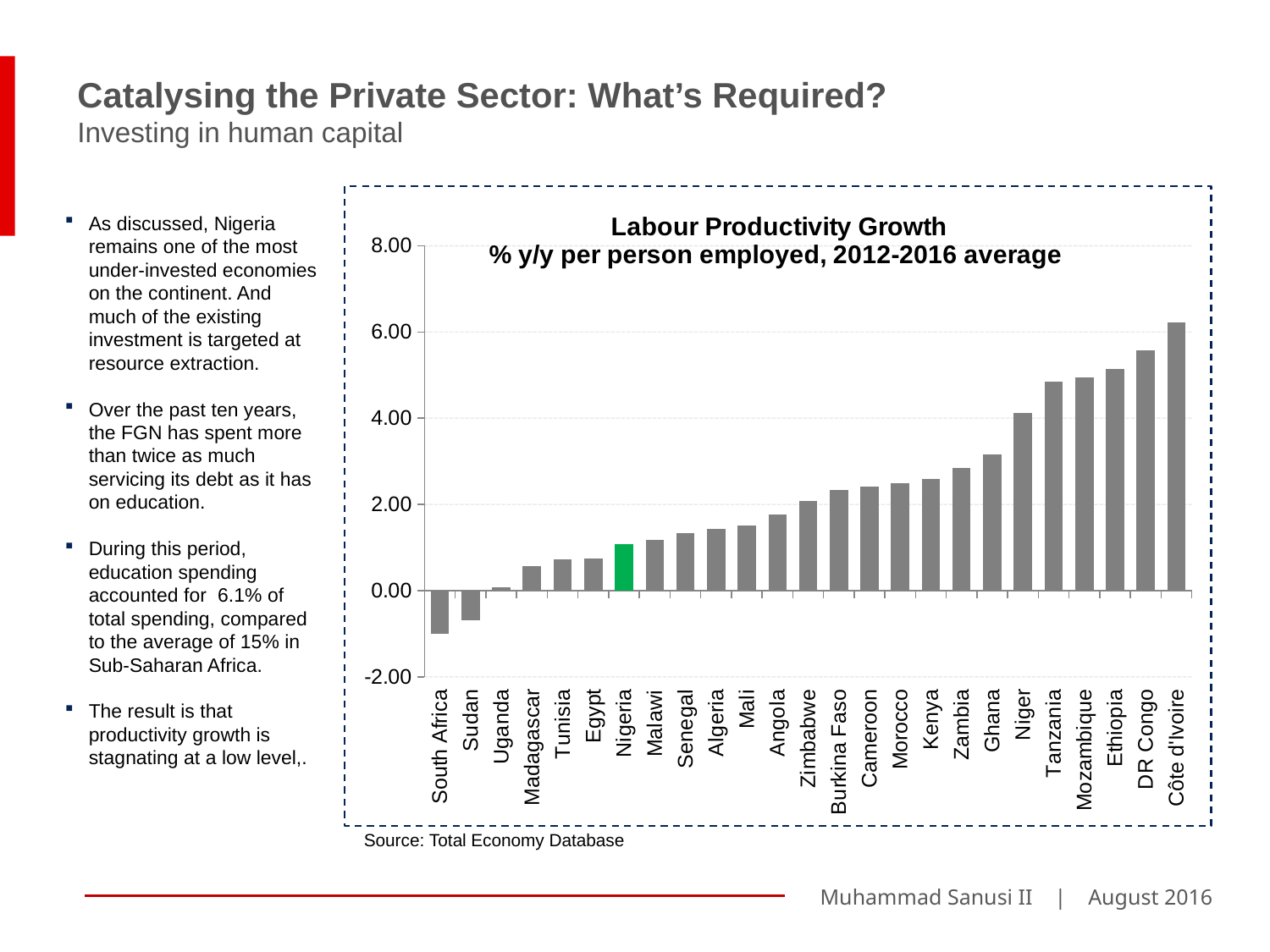
Which country has the lowest labour productivity growth in the chart? South Africa Which country has the highest labour productivity growth in the chart? Côte d'Ivoire Which has the larger labour productivity growth, Sudan or Uganda? Uganda Is the value for Ghana greater or less than 4.00? less Is the value for Côte d'Ivoire greater or less than 6.00? greater What kind of chart is shown on the slide? bar chart Do the bar values rise or fall moving from left to right along the x axis? rise How many countries are plotted in the Labour Productivity Growth chart? 25 Is the value for Nigeria greater or less than 2.00? less Which has the larger labour productivity growth, Ethiopia or Kenya? Ethiopia Which country's bar is highlighted in green in the chart? Nigeria